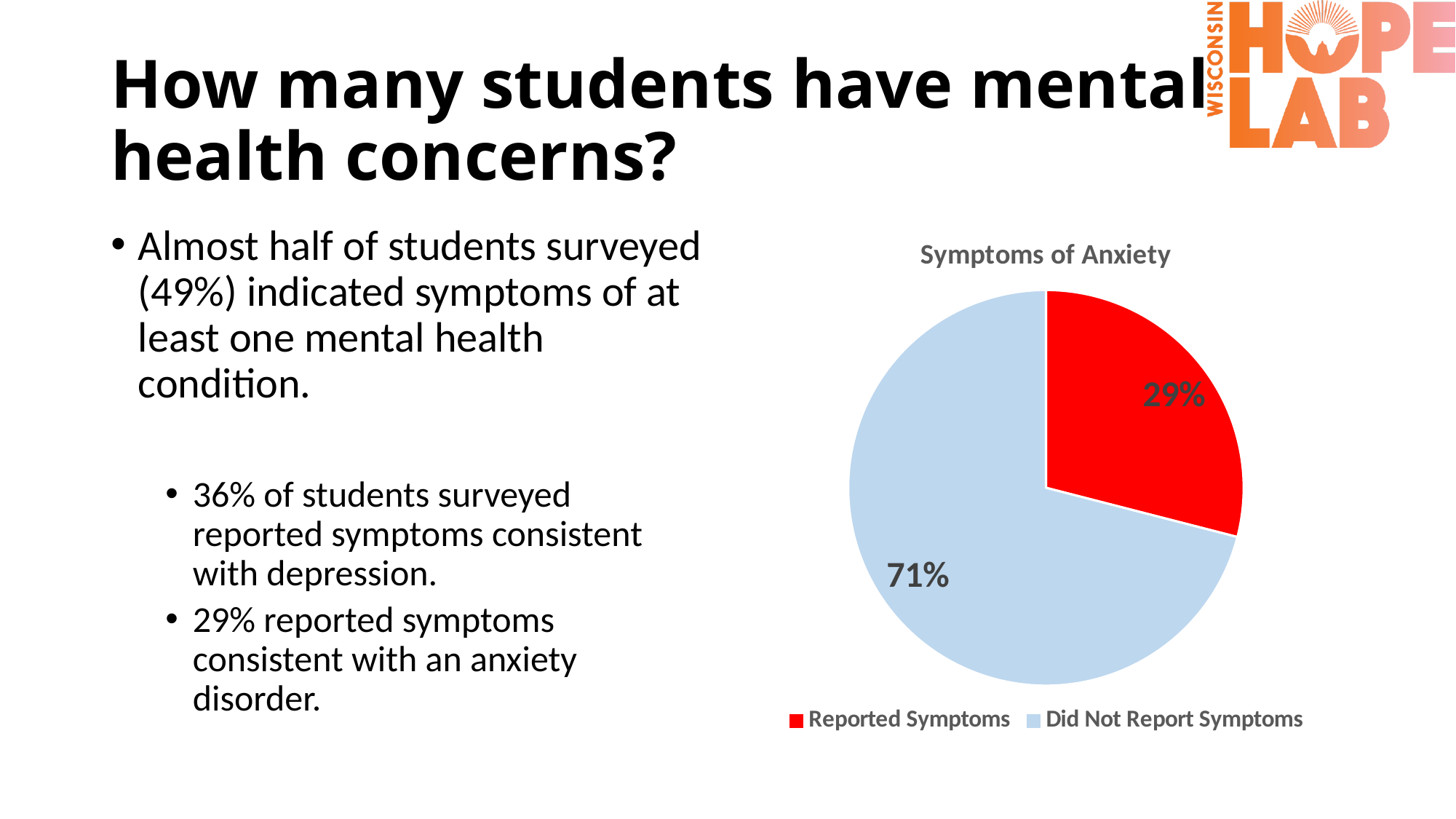
How many slices does the pie chart have? 2 What is the difference in percentage points between the Did Not Report Symptoms slice and the Reported Symptoms slice? 42 Which slice of the pie is the smallest? Reported Symptoms How many entries does the legend list? 2 What colour is the Reported Symptoms slice? red What kind of chart is shown on the slide? pie chart Which slice of the pie is the largest? Did Not Report Symptoms Which is larger, the Reported Symptoms slice or the Did Not Report Symptoms slice? Did Not Report Symptoms What percentage of the pie is labelled Reported Symptoms? 29% What percentage of the pie is labelled Did Not Report Symptoms? 71% What is the title of the chart? Symptoms of Anxiety What share of the pie does the Reported Symptoms slice represent? 29%